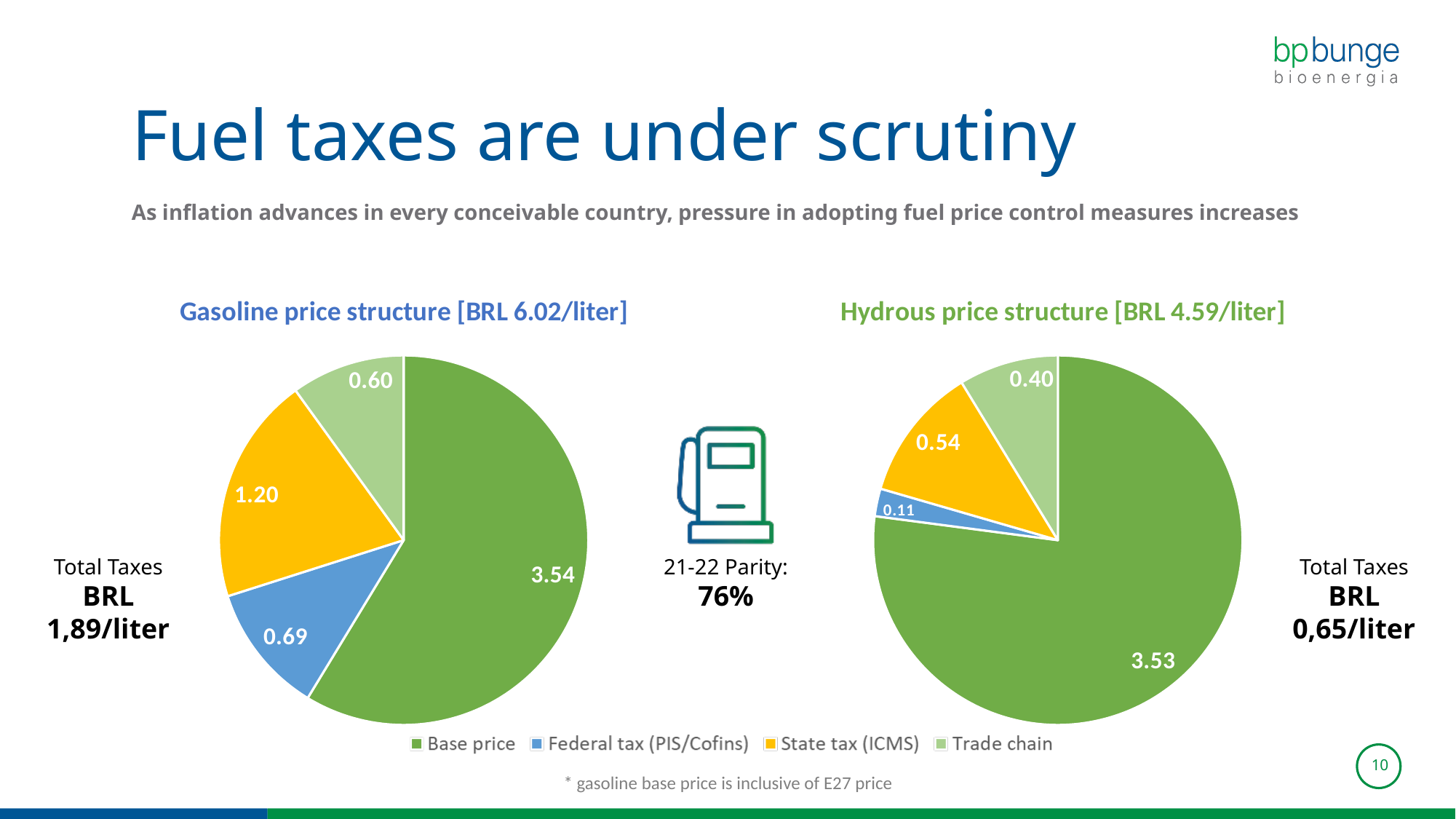
How many slices does the Hydrous price structure pie chart have? 4 In the Gasoline price structure pie chart, what is the value for State tax (ICMS)? 1.20 In the Gasoline price structure pie chart, what is the difference between the State tax (ICMS) and Federal tax (PIS/Cofins) values? 0.51 In the Hydrous price structure pie chart, what is the value for Federal tax (PIS/Cofins)? 0.11 In the Gasoline price structure pie chart, what is the value for Trade chain? 0.60 In the Hydrous price structure pie chart, which component has the smallest slice? Federal tax (PIS/Cofins) What type of chart is used for the Gasoline price structure? Pie chart How many series does the shared legend list? 4 In the Gasoline price structure pie chart, which component has the largest slice? Base price Which is larger: the Trade chain value in the Gasoline price structure chart or the Trade chain value in the Hydrous price structure chart? Gasoline price structure What is the difference between the State tax (ICMS) value in the Gasoline price structure chart and the State tax (ICMS) value in the Hydrous price structure chart? 0.66 In the Hydrous price structure pie chart, what is the value for Base price? 3.53